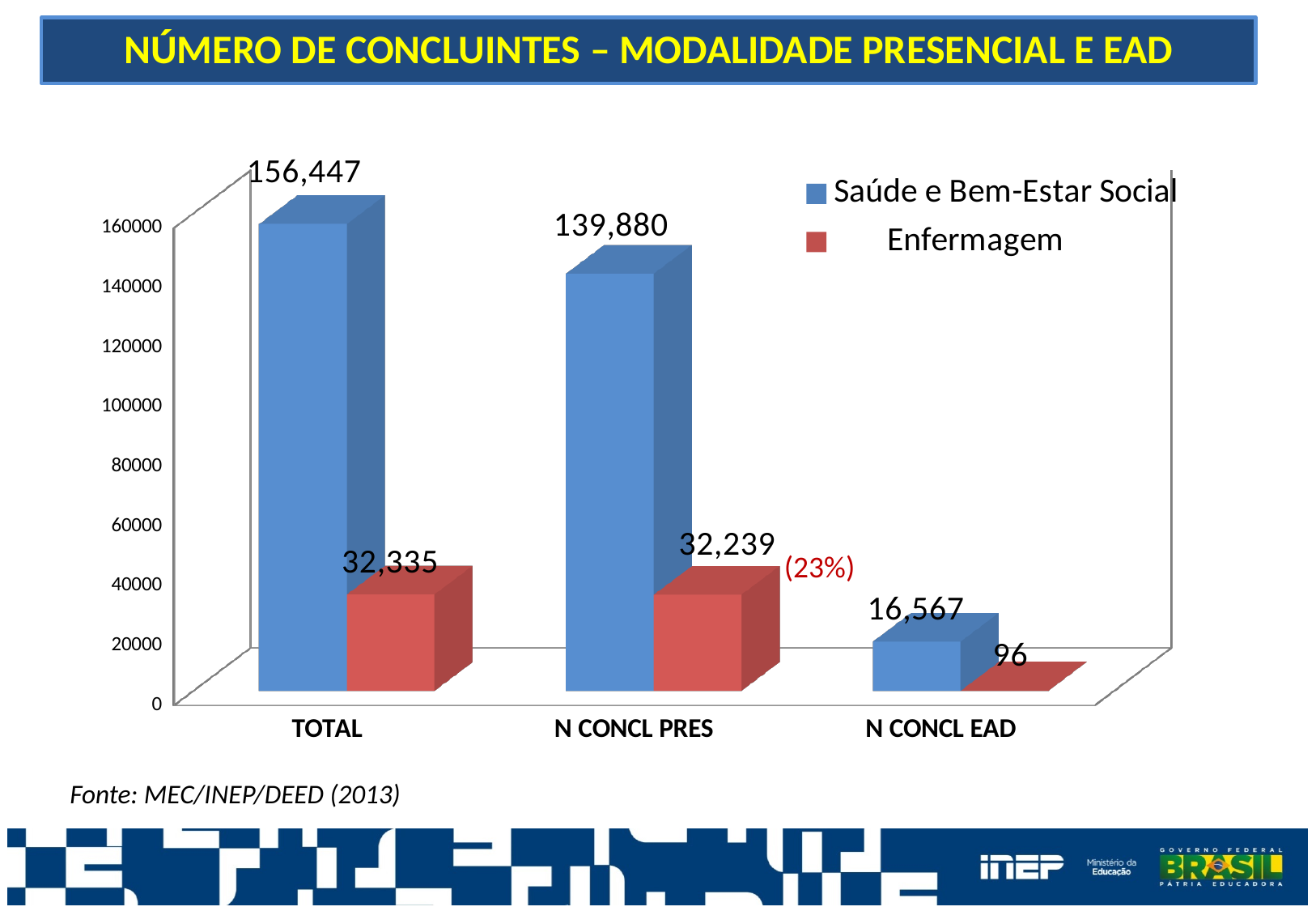
What percentage is shown in red next to the Enfermagem bar for N CONCL PRES? (23%) Which category has the lowest value for Enfermagem? N CONCL EAD Which category has the highest value for Saúde e Bem-Estar Social? TOTAL What is the value for Enfermagem in the N CONCL PRES category? 32,239 What kind of chart is shown on the slide? Bar chart What is the difference between the Saúde e Bem-Estar Social values for TOTAL and N CONCL PRES? 16,567 How many categories are shown on the x axis? 3 What is the value for Saúde e Bem-Estar Social in the N CONCL EAD category? 16,567 What is the value for Enfermagem in the N CONCL EAD category? 96 How many series does the legend list? 2 What is the value for Saúde e Bem-Estar Social in the TOTAL category? 156,447 Which is larger: the Enfermagem value for TOTAL or for N CONCL PRES? TOTAL